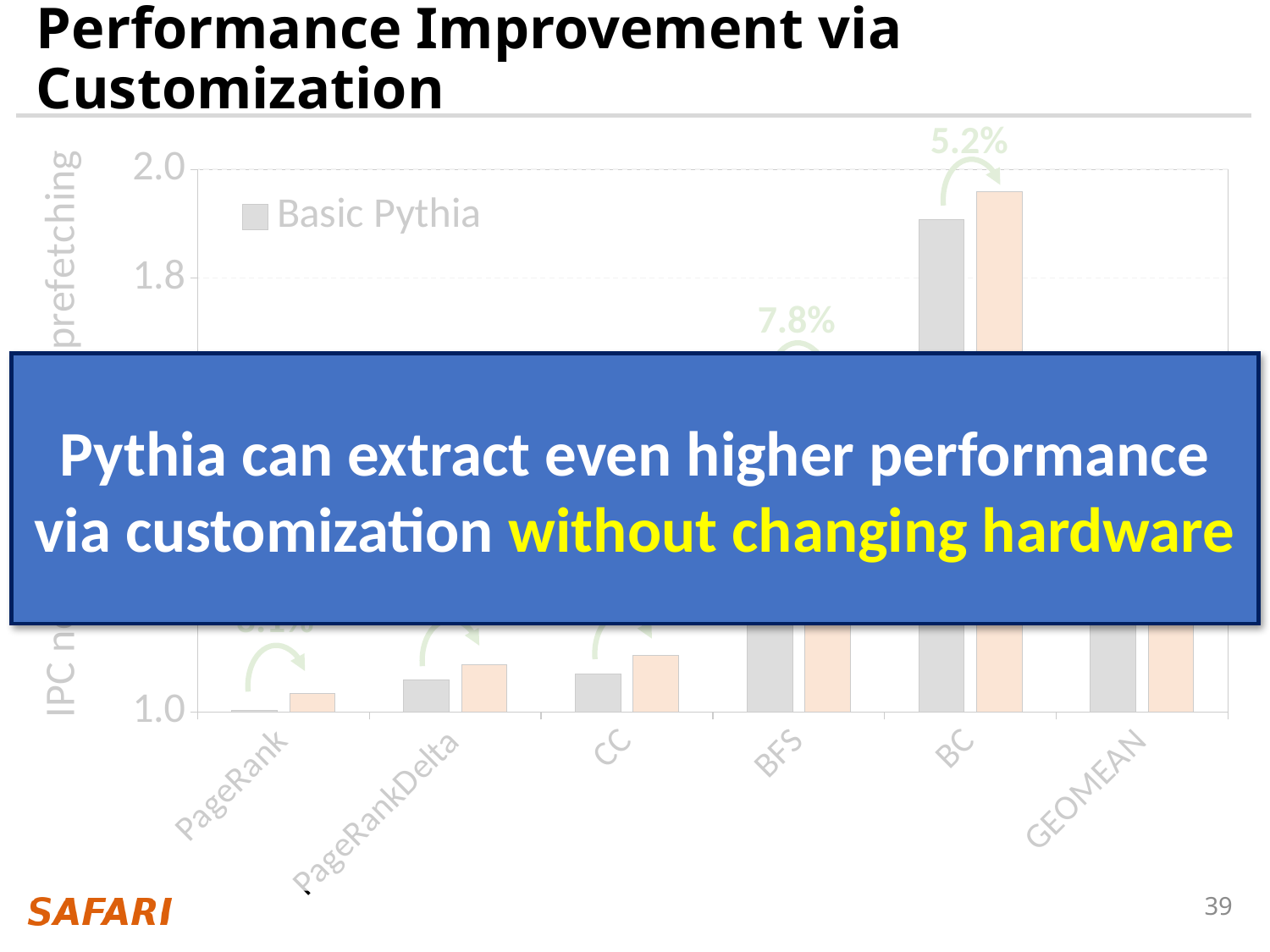
How many categories are shown along the x axis of the chart? 6 Is the Basic Pythia value for BC greater or less than 1.8? greater What is the highest tick value shown on the y axis? 2.0 What kind of chart is shown on the slide? bar chart Which has the larger Basic Pythia value, BC or PageRank? BC What series name is shown in the chart's legend? Basic Pythia Which category has the lowest Basic Pythia value? PageRank What percentage improvement is annotated above the BFS bars? 7.8% What percentage improvement is annotated above the BC bars? 5.2% Which has the larger Basic Pythia value, BC or CC? BC Which category has the highest Basic Pythia value? BC Is the Basic Pythia value for PageRank greater or less than 1.8? less